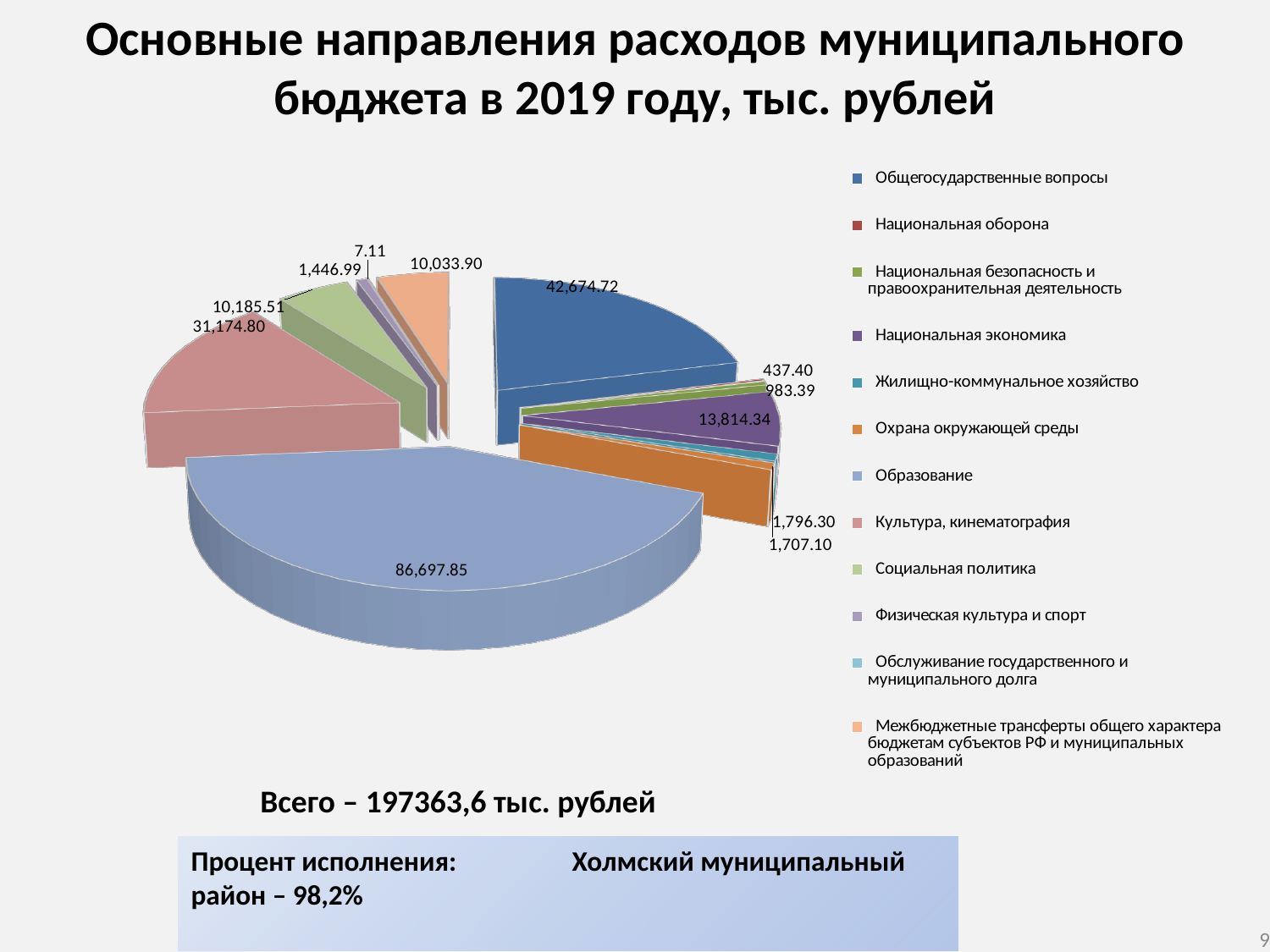
What is the difference between the values for Образование and Общегосударственные вопросы? 44,023.13 What kind of chart is shown on the slide? Pie chart What is the value for Общегосударственные вопросы? 42,674.72 What is the value for Обслуживание государственного и муниципального долга? 7.11 What is the value for Образование? 86,697.85 Which category has the largest slice of the pie? Образование What is the value for Культура, кинематография? 31,174.80 Which is larger, the value for Социальная политика or the value for Межбюджетные трансферты общего характера бюджетам субъектов РФ и муниципальных образований? Социальная политика What is the value for Национальная экономика? 13,814.34 What total amount in thousand rubles is stated below the chart? 197363,6 тыс. рублей How many categories does the legend of the pie chart list? 12 Which category has the smallest slice of the pie? Обслуживание государственного и муниципального долга